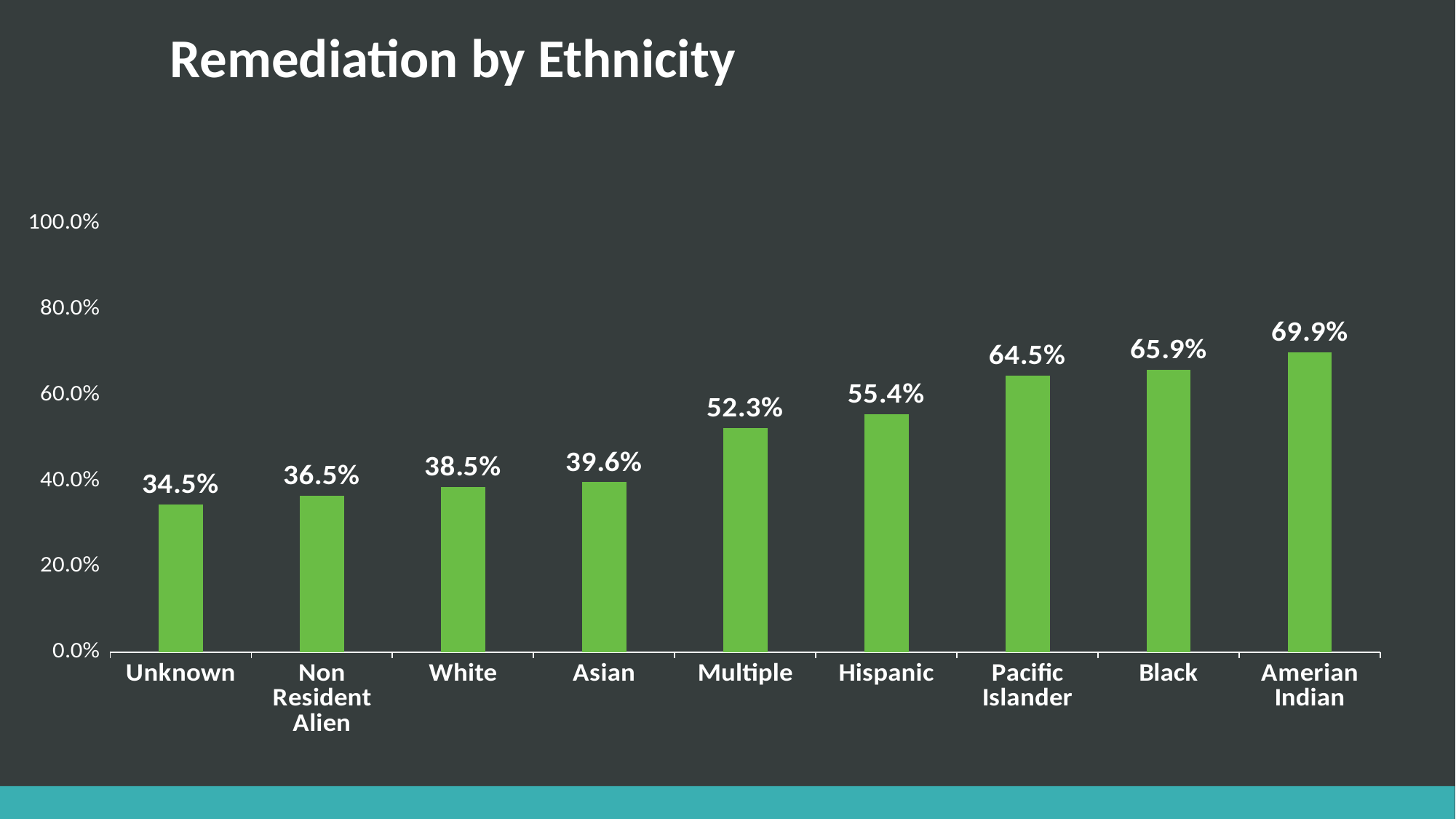
What is the difference between the Black and Pacific Islander values? 1.4% How many ethnicity categories are shown on the chart? 9 What is the value shown for Non Resident Alien? 36.5% Do the values rise or fall from left to right along the x axis? Rise Which is larger, the value for Multiple or the value for Asian? Multiple Which category has the highest remediation rate? Amerian Indian Is the value for Pacific Islander greater or less than 60.0%? greater What is the remediation rate for Hispanic students? 55.4% What is the remediation rate for White? 38.5% What kind of chart is shown on the slide? Bar chart What is the difference between the Multiple and Asian values? 12.7% Which category has the lowest remediation rate? Unknown